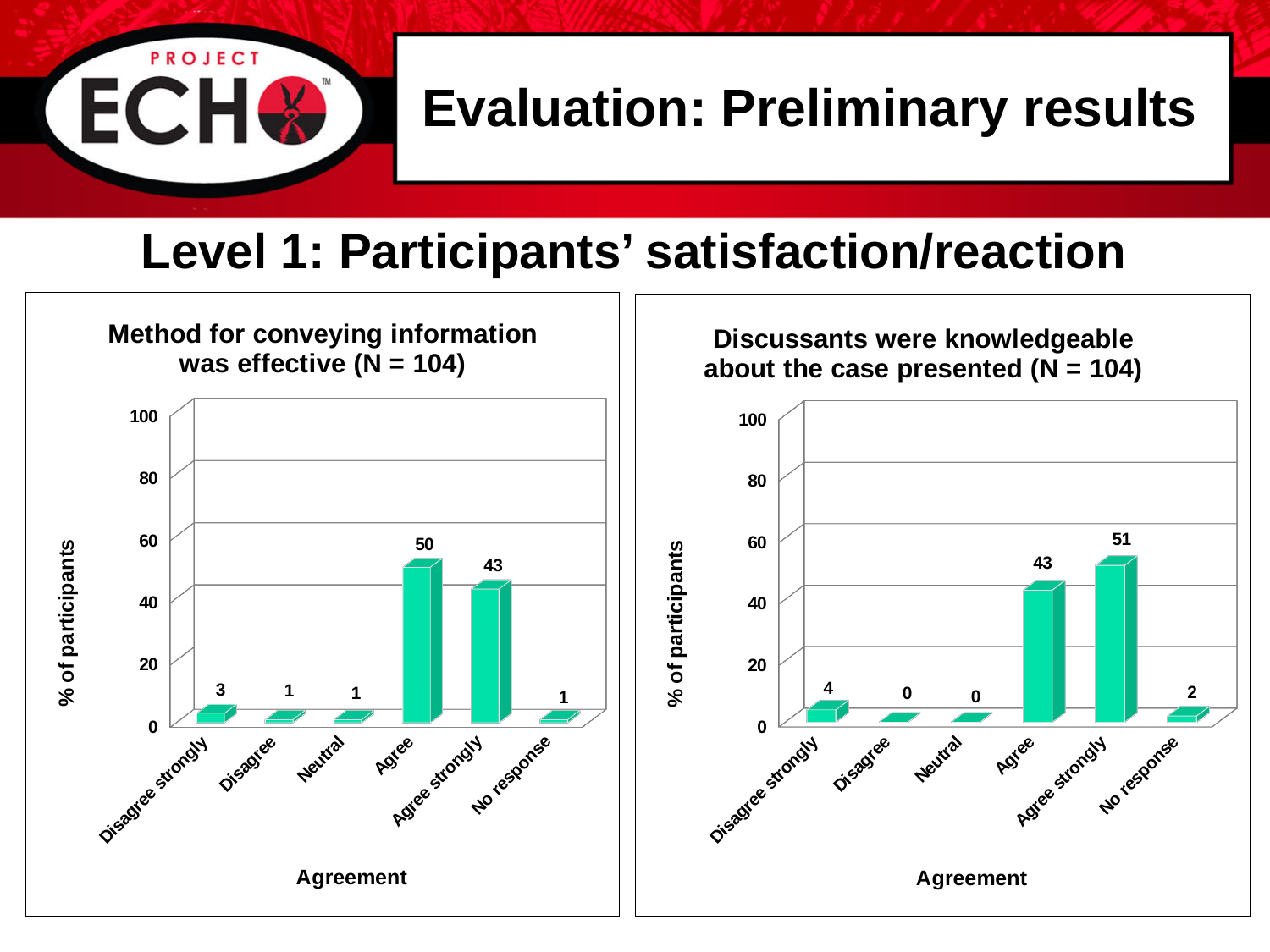
In the chart titled "Method for conveying information was effective (N = 104)", what is the value for Agree? 50 In the left chart, which category has the highest value? Agree In the right chart, which category has the highest value? Agree strongly In the chart titled "Discussants were knowledgeable about the case presented (N = 104)", what is the value for Agree strongly? 51 In the right chart, what is the difference between the values for Agree strongly and Agree? 8 How many categories are shown on the x axis of the left chart? 6 In the chart titled "Method for conveying information was effective (N = 104)", what is the value for Disagree strongly? 3 What kind of chart is the chart titled "Discussants were knowledgeable about the case presented (N = 104)"? Bar chart In the right chart, which is larger, the value for Agree or the value for Agree strongly? Agree strongly In the left chart, what is the difference between the values for Agree and Agree strongly? 7 What is the y-axis label of the left chart? % of participants In the chart titled "Discussants were knowledgeable about the case presented (N = 104)", what is the value for No response? 2